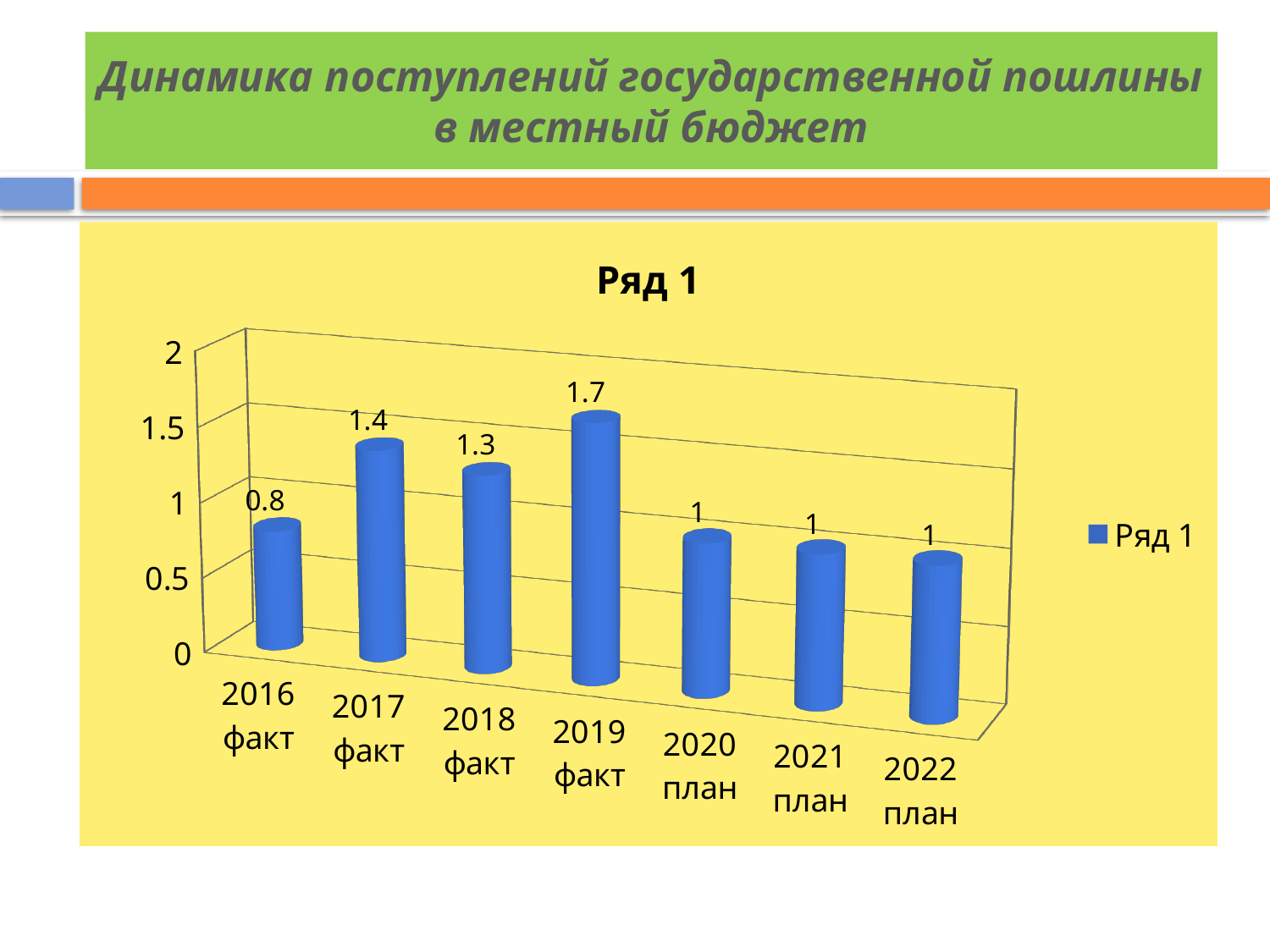
Which category has the highest value? 2019 факт What is the value for 2016 факт? 0.8 How many categories are shown on the x axis? 7 How many series does the legend list? 1 What kind of chart is shown? bar chart What is the value for 2019 факт? 1.7 Which category has the lowest value? 2016 факт What is the value for 2021 план? 1 Which is larger, the value for 2017 факт or the value for 2020 план? 2017 факт What is the difference between the values for 2019 факт and 2018 факт? 0.4 Is the value for 2017 факт greater or less than 1? greater What is the title of the chart? Ряд 1